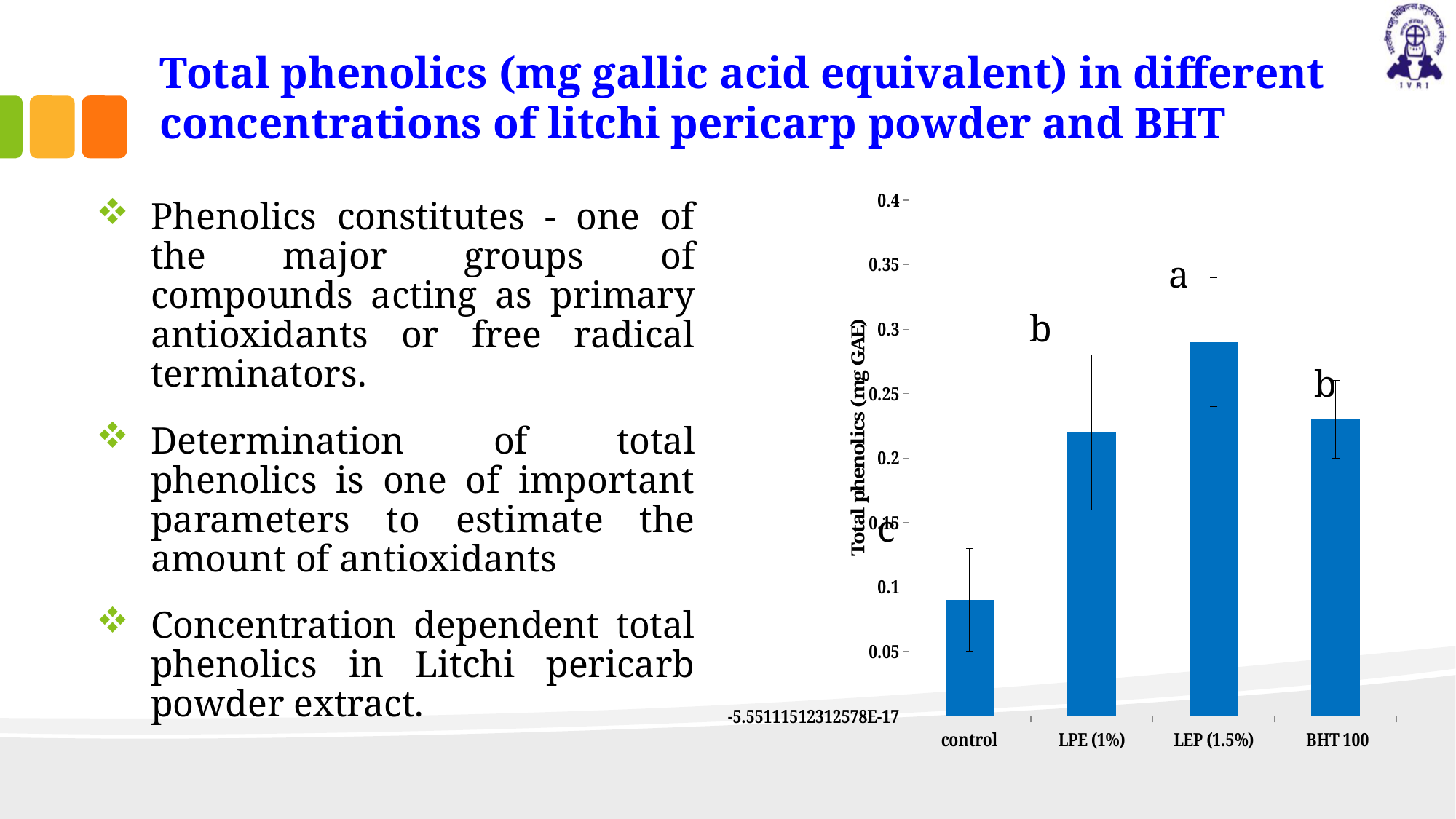
Is the value for LEP (1.5%) greater or less than 0.25? greater Is the value for BHT 100 greater or less than 0.3? less Is the value for control greater or less than 0.1? less Which letter is printed above the LEP (1.5%) bar? a How many categories are plotted on the x axis of the chart? 4 Which category has the highest total phenolics value? LEP (1.5%) Which has the larger total phenolics value, control or LEP (1.5%)? LEP (1.5%) What is the label of the y axis of the chart? Total phenolics (mg GAE) Which category has the lowest total phenolics value? control Which has the larger total phenolics value, control or LPE (1%)? LPE (1%) What kind of chart is shown on the slide? bar chart